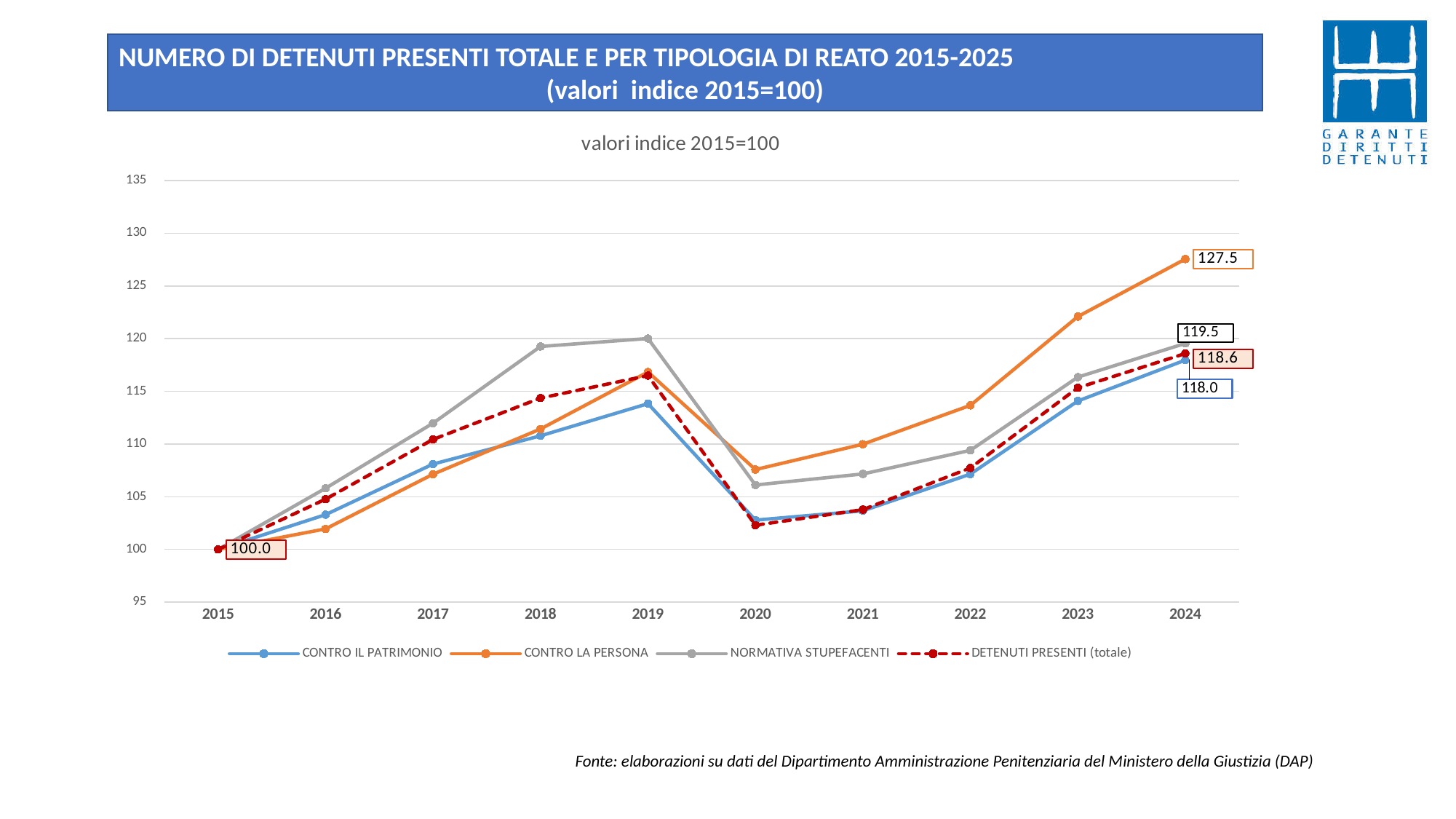
How many series does the legend list? 4 Is the value for NORMATIVA STUPEFACENTI in 2019 greater or less than 115? greater What is the value of NORMATIVA STUPEFACENTI in 2024? 119.5 What is the difference between CONTRO LA PERSONA and CONTRO IL PATRIMONIO in 2024? 9.5 Is the value for CONTRO LA PERSONA in 2020 greater or less than 110? less What is the value of CONTRO IL PATRIMONIO in 2024? 118.0 How many years are shown on the x axis? 10 What kind of chart is shown on the slide? line chart What is the value of CONTRO LA PERSONA in 2024? 127.5 Which series has the highest value in 2024? CONTRO LA PERSONA What is the value of DETENUTI PRESENTI (totale) in 2024? 118.6 Which series is drawn as a dashed line? DETENUTI PRESENTI (totale)